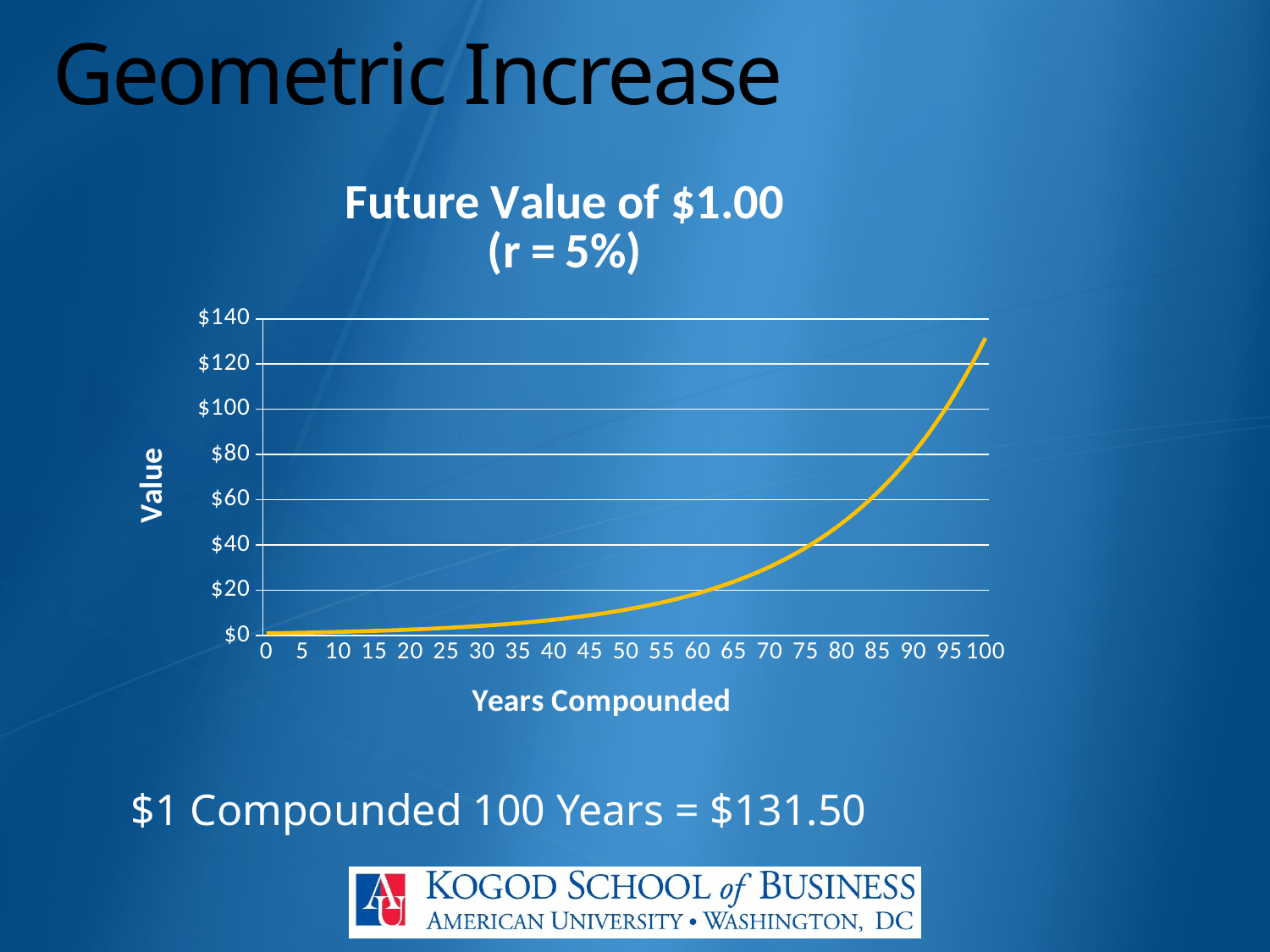
Which is larger, the value at 100 years compounded or the value at 50 years compounded? 100 years compounded How many tick labels are shown on the x axis of the chart? 21 Is the value at 50 years compounded greater or less than $20? less At which number of years compounded is the value lowest? 0 Is the value at 80 years compounded greater or less than $40? greater Is the value at 100 years compounded greater or less than $120? greater What kind of chart is shown on the slide? line chart At which number of years compounded is the value highest? 100 What is the title of the chart? Future Value of $1.00 (r = 5%) What is the label of the x axis of the chart? Years Compounded Does the value rise or fall as the years compounded increase along the x axis? rise According to the slide, what is the value of $1 compounded for 100 years? $131.50